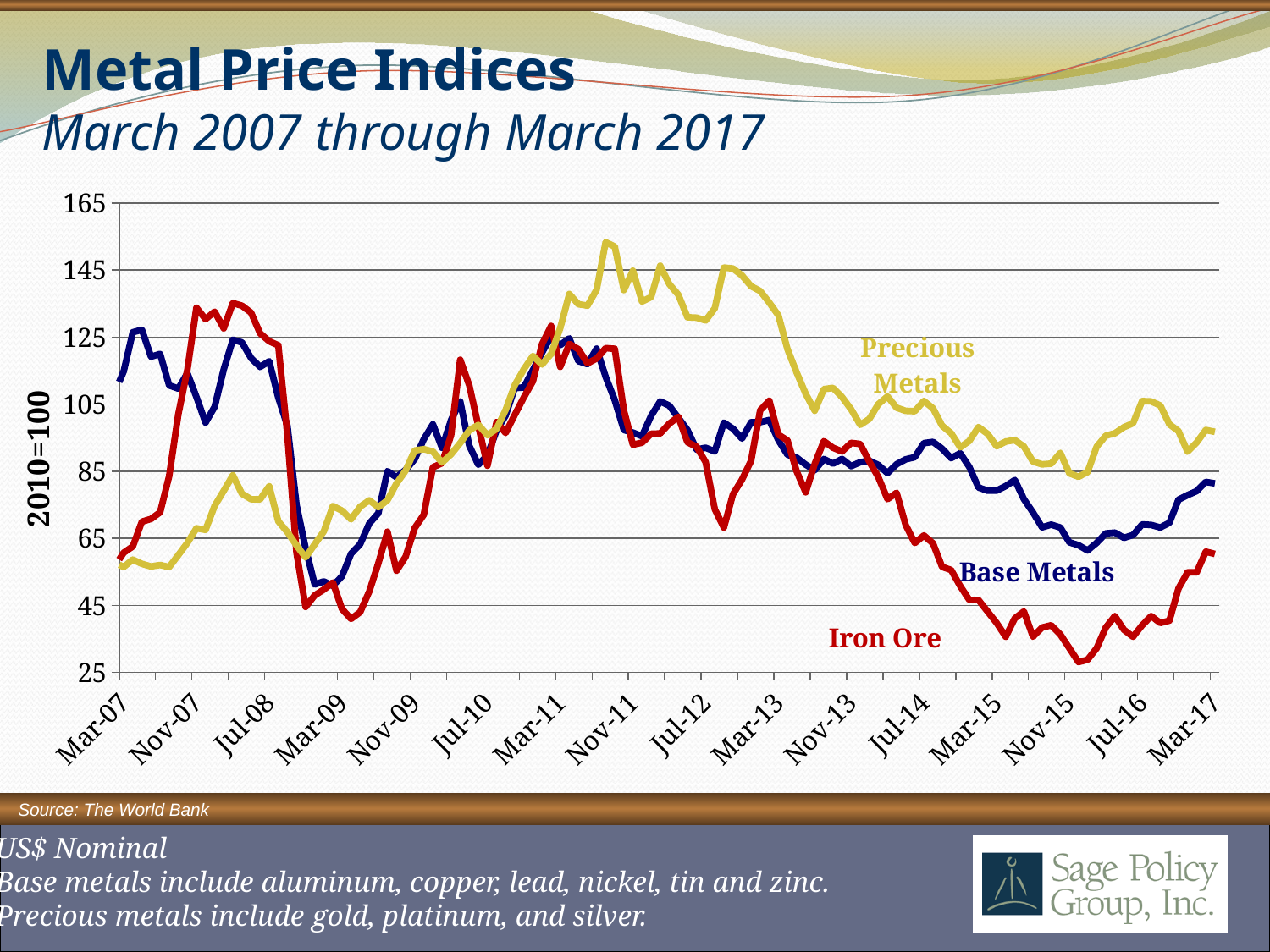
Which series is the lowest at Mar-17? Iron Ore Is the peak value of Precious Metals (around late 2011) greater or less than 145? greater Is the value for Iron Ore at Mar-17 greater or less than 45? greater Is the value for Base Metals at Mar-07 greater or less than 105? greater What is the label on the vertical axis of the chart? 2010=100 Does the Iron Ore series rise or fall between Mar-13 and Nov-15? fall Which series is the highest at Mar-17? Precious Metals How many series are plotted on the chart? 3 Does the Precious Metals series rise or fall between Mar-09 and Jul-11? rise What kind of chart is shown on the slide? Line chart At Mar-17, is the value for Precious Metals or Iron Ore larger? Precious Metals